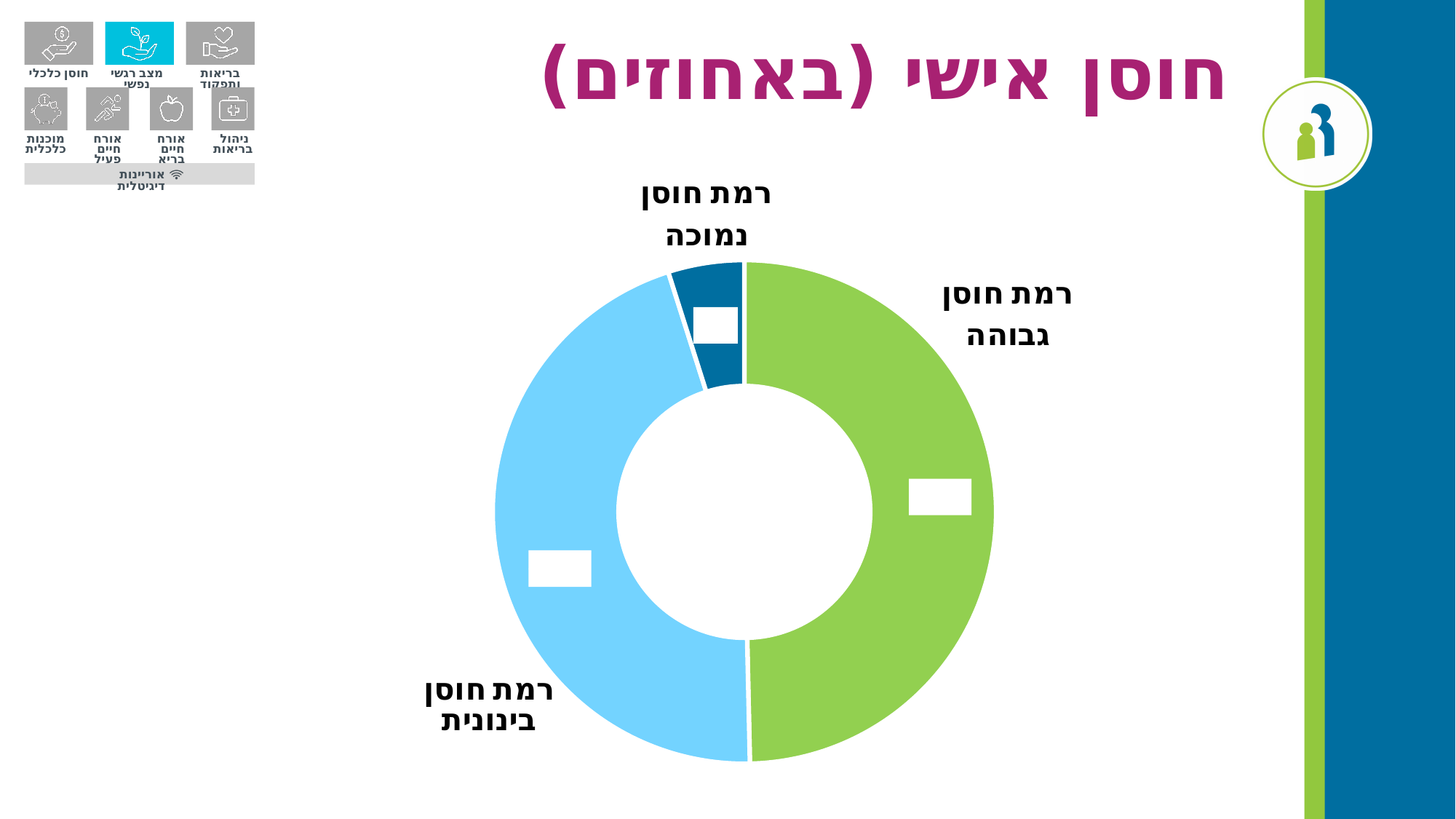
Which slice is larger: רמת חוסן גבוהה or רמת חוסן בינונית? רמת חוסן גבוהה How many categories does the pie chart show? 3 What colour is the slice for רמת חוסן גבוהה? Green Which slice is larger: רמת חוסן בינונית or רמת חוסן נמוכה? רמת חוסן בינונית Which category has the largest slice in the pie chart? רמת חוסן גבוהה Which category has the smallest slice in the pie chart? רמת חוסן נמוכה What kind of chart is shown on the slide? Pie chart (donut) What is the title of the slide containing the pie chart? חוסן אישי (באחוזים)